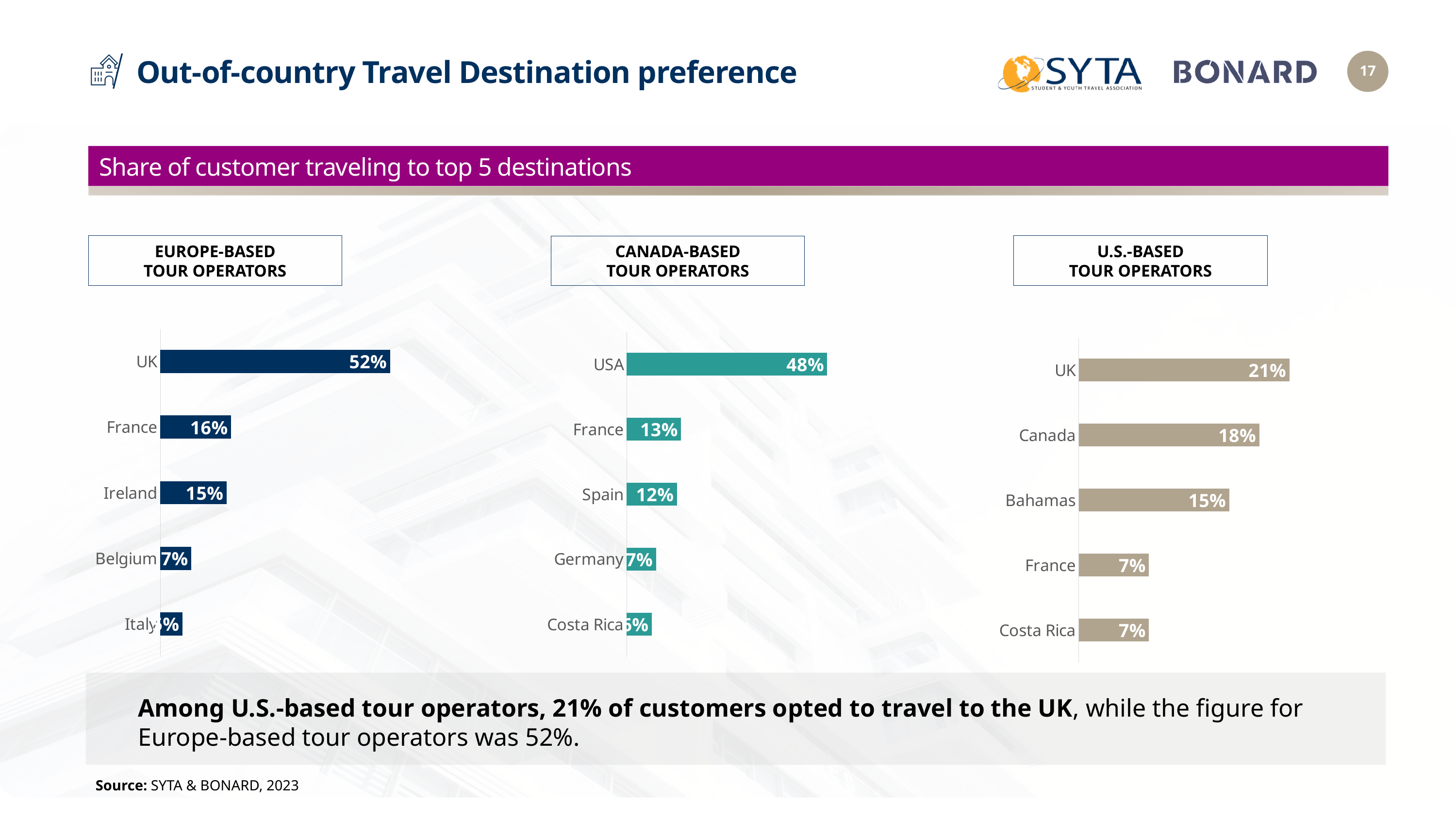
In the Europe-based tour operators chart, what share of customers traveled to the UK? 52% In the Europe-based tour operators chart, what is the difference between the UK and France values? 36% What type of chart is used for the Europe-based tour operators data? Bar chart In the U.S.-based tour operators chart, which destination has the highest share? UK In the U.S.-based tour operators chart, what is the value for Canada? 18% In the Canada-based tour operators chart, what is the value for Spain? 12% In the Canada-based tour operators chart, which destination has the lowest share? Costa Rica In the Canada-based tour operators chart, which is larger, France or Germany? France How many destinations are shown in the U.S.-based tour operators chart? 5 In the Canada-based tour operators chart, what share of customers traveled to the USA? 48% In the U.S.-based tour operators chart, what is the difference between the UK and Bahamas values? 6% In the Europe-based tour operators chart, what is the value for Ireland? 15%